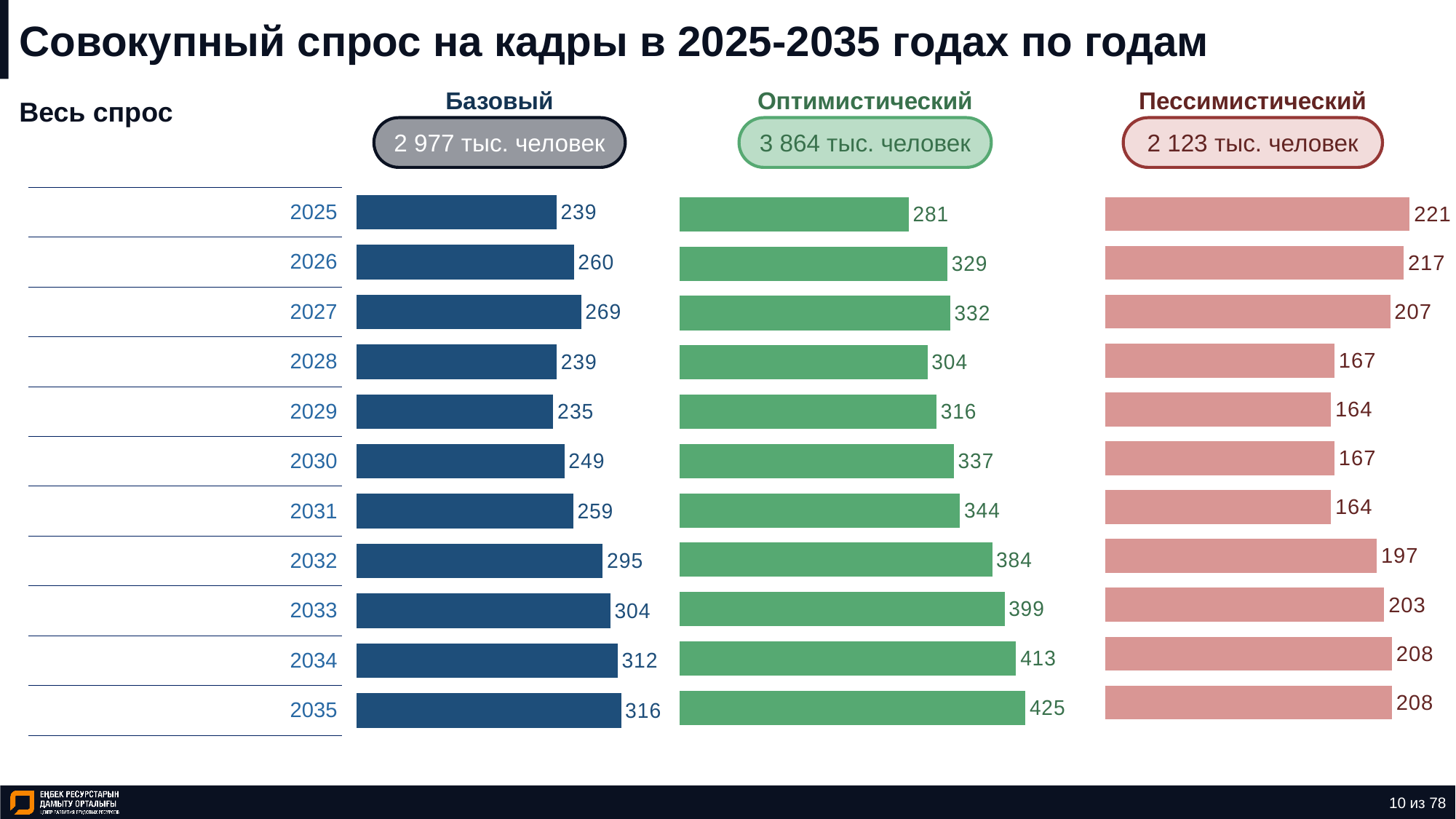
In the Оптимистический chart, what is the value for 2030? 337 In the Пессимистический chart, which is larger: the value for 2026 or the value for 2028? 2026 In the Оптимистический chart, which year has the lowest value? 2025 How many years are shown in the Базовый chart? 11 In the Пессимистический chart, what is the value for 2032? 197 In the Пессимистический chart, which year has the highest value? 2025 What total is shown in the rounded label above the Пессимистический chart? 2 123 тыс. человек In the Оптимистический chart, what is the difference between the values for 2035 and 2025? 144 What kind of chart is used for the Оптимистический scenario? Bar chart In the Базовый chart, which year has the highest value? 2035 In the Базовый chart, which year has the lowest value? 2029 In the Базовый chart, what is the value for 2027? 269